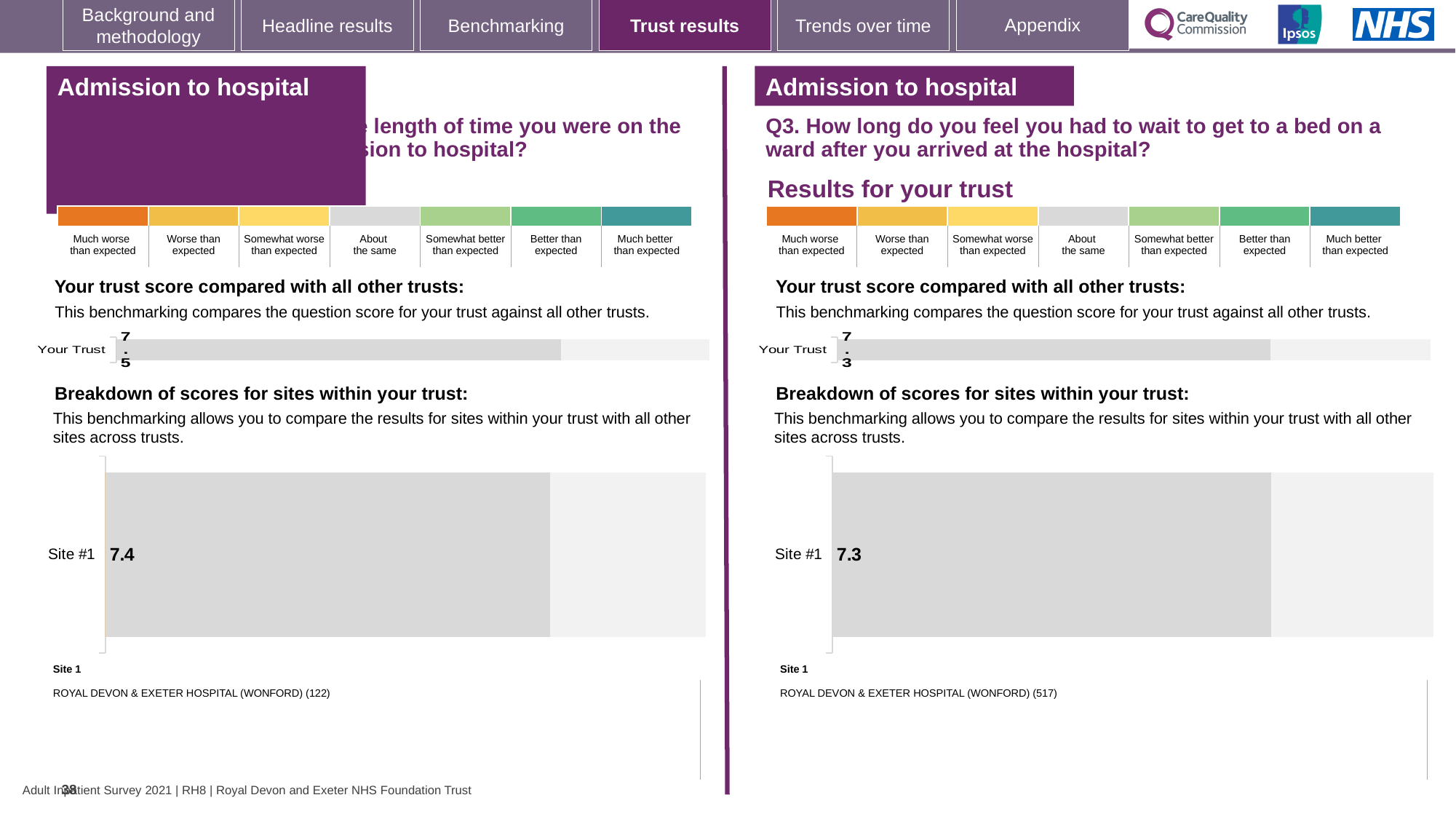
On the left-hand 'Your trust score compared with all other trusts' chart, what is the score shown for Your Trust? 7.5 On the left-hand side of the slide, which is higher: the Your Trust score or the Site #1 score? Your Trust On the left-hand 'Breakdown of scores for sites within your trust' chart, what is the score for Site #1? 7.4 Which hospital is listed as Site 1 beneath the right-hand (Q3) breakdown chart? ROYAL DEVON & EXETER HOSPITAL (WONFORD) On the right-hand (Q3) 'Your trust score compared with all other trusts' chart, what is the score shown for Your Trust? 7.3 What number appears in brackets after the Site 1 hospital name beneath the left-hand breakdown chart? 122 On the left-hand side of the slide, what is the difference between the Your Trust score and the Site #1 score? 0.1 Which Your Trust score is higher: the one on the left-hand chart or the one on the right-hand (Q3) chart? The left-hand chart What type of chart is used to show the Site #1 score on the right-hand (Q3) side of the slide? Bar chart On the right-hand (Q3) side of the slide, what is the difference between the Your Trust score and the Site #1 score? 0 On the right-hand (Q3) 'Breakdown of scores for sites within your trust' chart, what is the score for Site #1? 7.3 How many sites are shown in the left-hand 'Breakdown of scores for sites within your trust' chart? 1